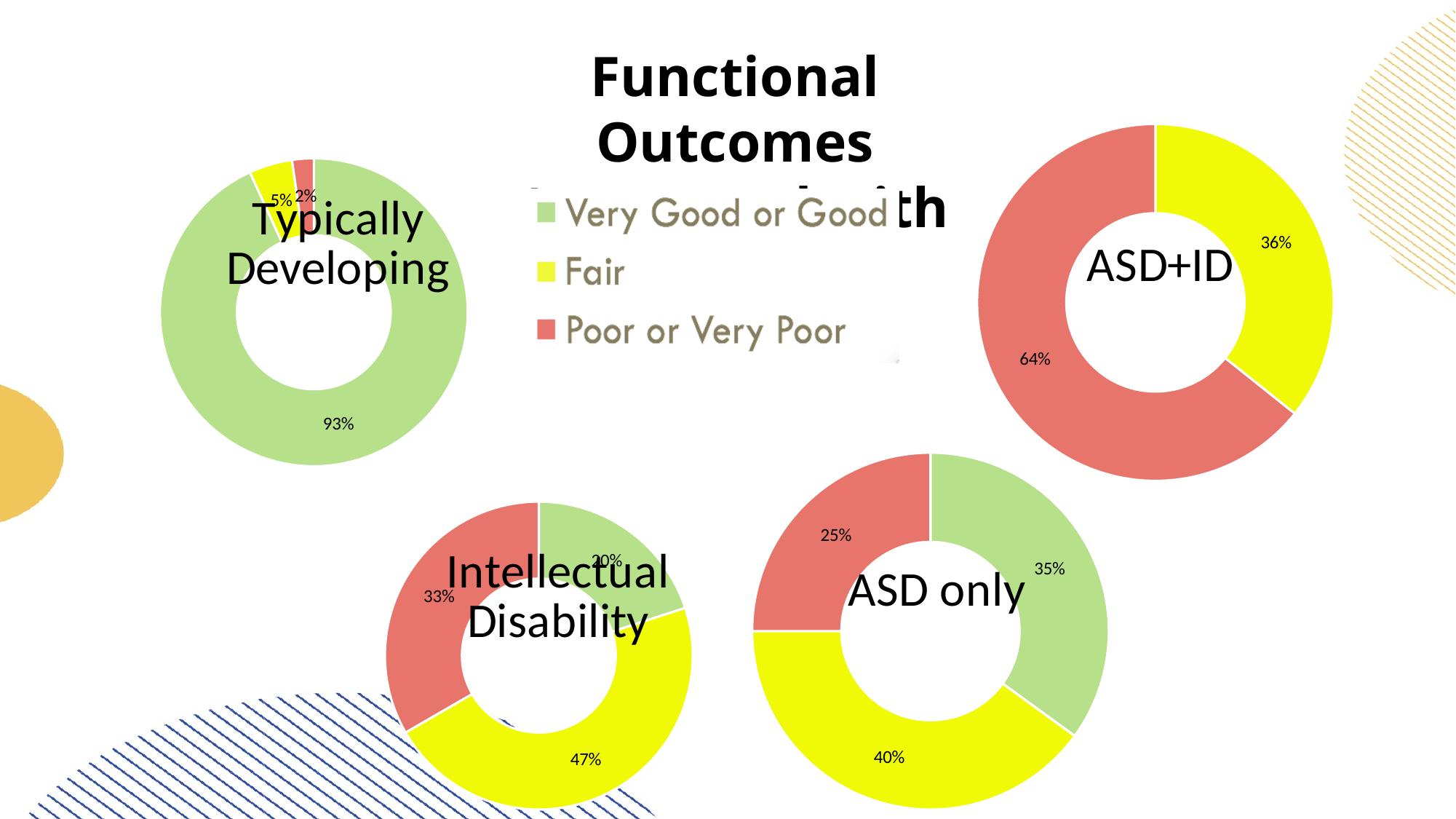
In the Typically Developing chart, what percentage is Very Good or Good? 93% How many categories does the legend list? 3 How many doughnut charts are shown on the slide? 4 What kind of chart is used for the ASD only data? Doughnut chart In the ASD only chart, what percentage is Very Good or Good? 35% In the ASD+ID chart, what percentage is Poor or Very Poor? 64% In the Typically Developing chart, which category has the smallest share? Poor or Very Poor In the Intellectual Disability chart, which is larger: Poor or Very Poor, or Very Good or Good? Poor or Very Poor In the Intellectual Disability chart, what percentage is Fair? 47% Which colour represents Fair in the legend? Yellow In the ASD+ID chart, what is the difference between the Poor or Very Poor share and the Fair share? 28% In the ASD only chart, which category has the largest share? Fair